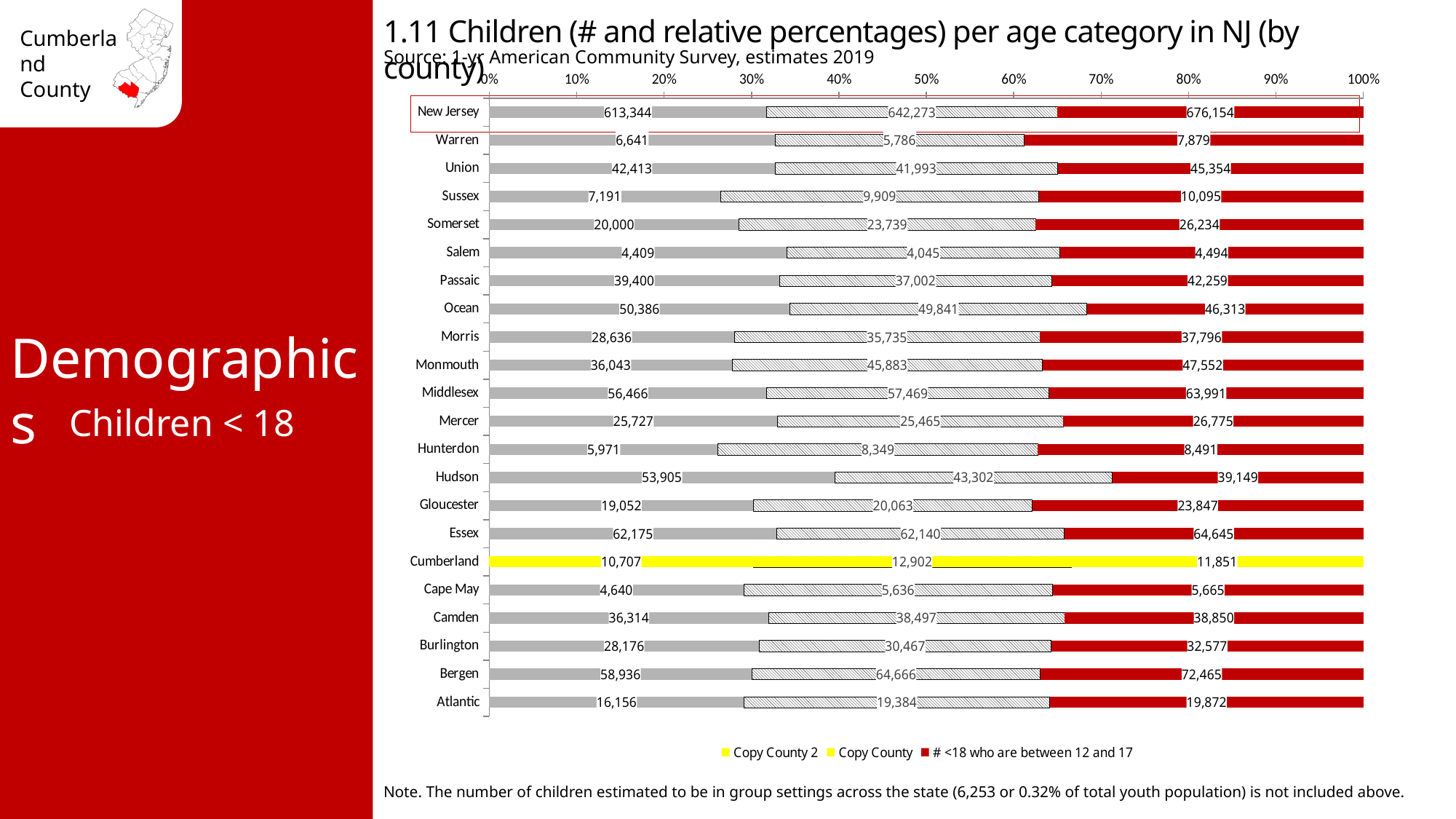
How many entries does the chart legend list? 3 Which county's bar is highlighted in yellow on the chart? Cumberland What type of chart is shown on the slide? Stacked bar chart What is the value printed on the first (leftmost) segment of the New Jersey bar? 613,344 Which has the larger red '# <18 who are between 12 and 17' value, Ocean or Hudson? Ocean Among the counties (excluding the New Jersey total), which has the largest value in the red '# <18 who are between 12 and 17' segment? Bergen Which county has the smallest value in the red '# <18 who are between 12 and 17' segment? Salem What is the value of the red '# <18 who are between 12 and 17' segment for Cumberland? 11,851 What is the difference between the red segment values for Bergen (72,465) and Essex (64,645)? 7,820 How many counties/regions are listed on the vertical axis of the chart? 22 What is the total of the three values printed on the Cumberland bar (10,707, 12,902 and 11,851)? 35,460 What is the value of the red '# <18 who are between 12 and 17' segment for Bergen? 72,465